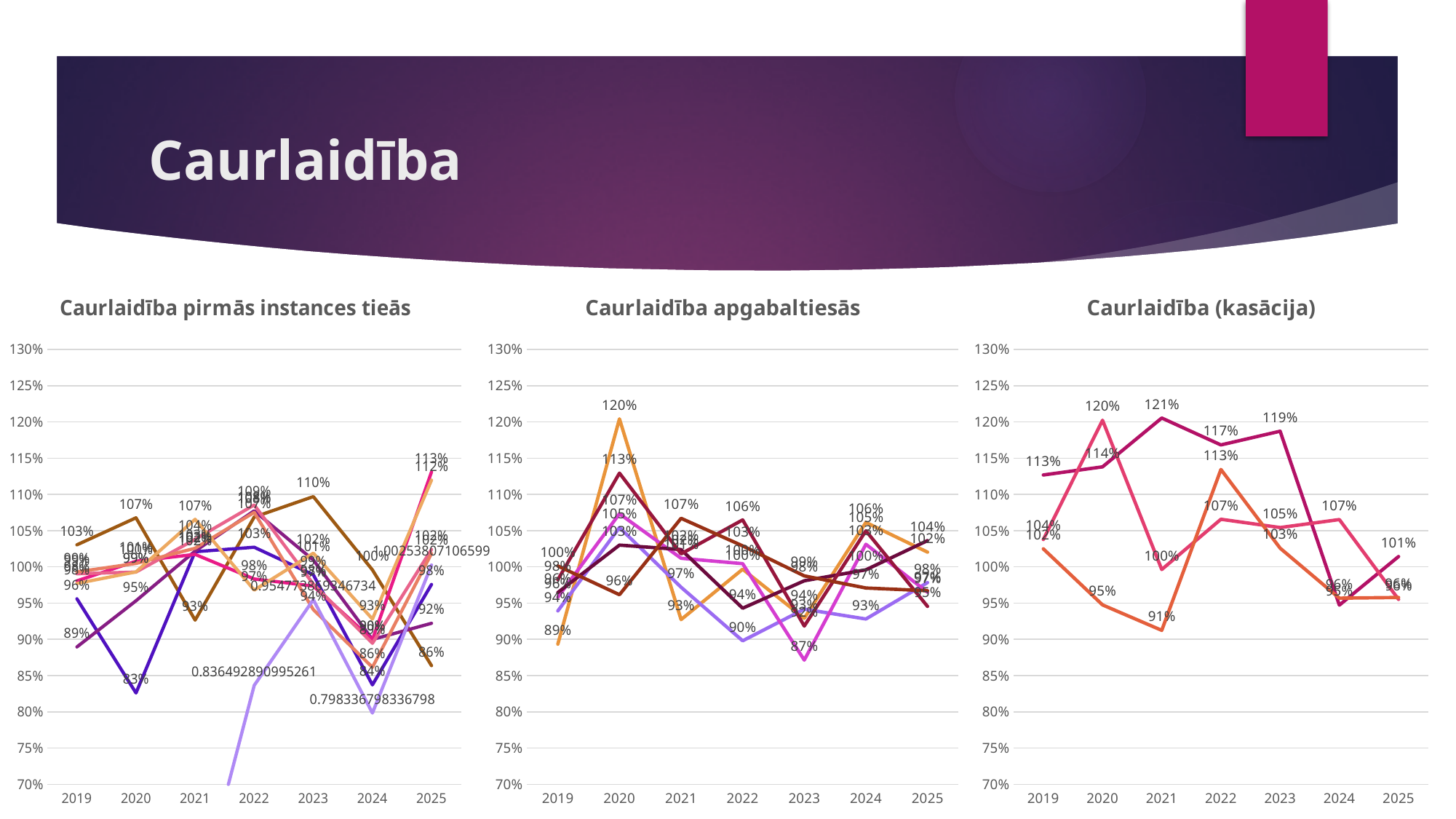
How many years are shown on the x axis of 'Caurlaidība apgabaltiesās'? 7 In 'Caurlaidība (kasācija)', in which year does the highest labelled value (121%) occur? 2021 What is the title of the leftmost chart on the slide? Caurlaidība pirmās instances tieās In 'Caurlaidība (kasācija)', is the lowest value in 2021 greater or less than 95%? less How many charts are on the slide? 3 What kind of chart is 'Caurlaidība (kasācija)'? line chart In 'Caurlaidība apgabaltiesās', what is the lowest value labelled on the chart? 87% In 'Caurlaidība (kasācija)', what is the difference between the highest labelled value (121%) and the lowest labelled value (91%)? 30 percentage points In 'Caurlaidība apgabaltiesās', what is the highest value labelled on the chart, and in which year? 120% in 2020 In 'Caurlaidība (kasācija)', what is the lowest value labelled on the chart? 91% In 'Caurlaidība (kasācija)', what is the highest value labelled on the chart? 121% What is the top value shown on the y axis of the charts? 130%